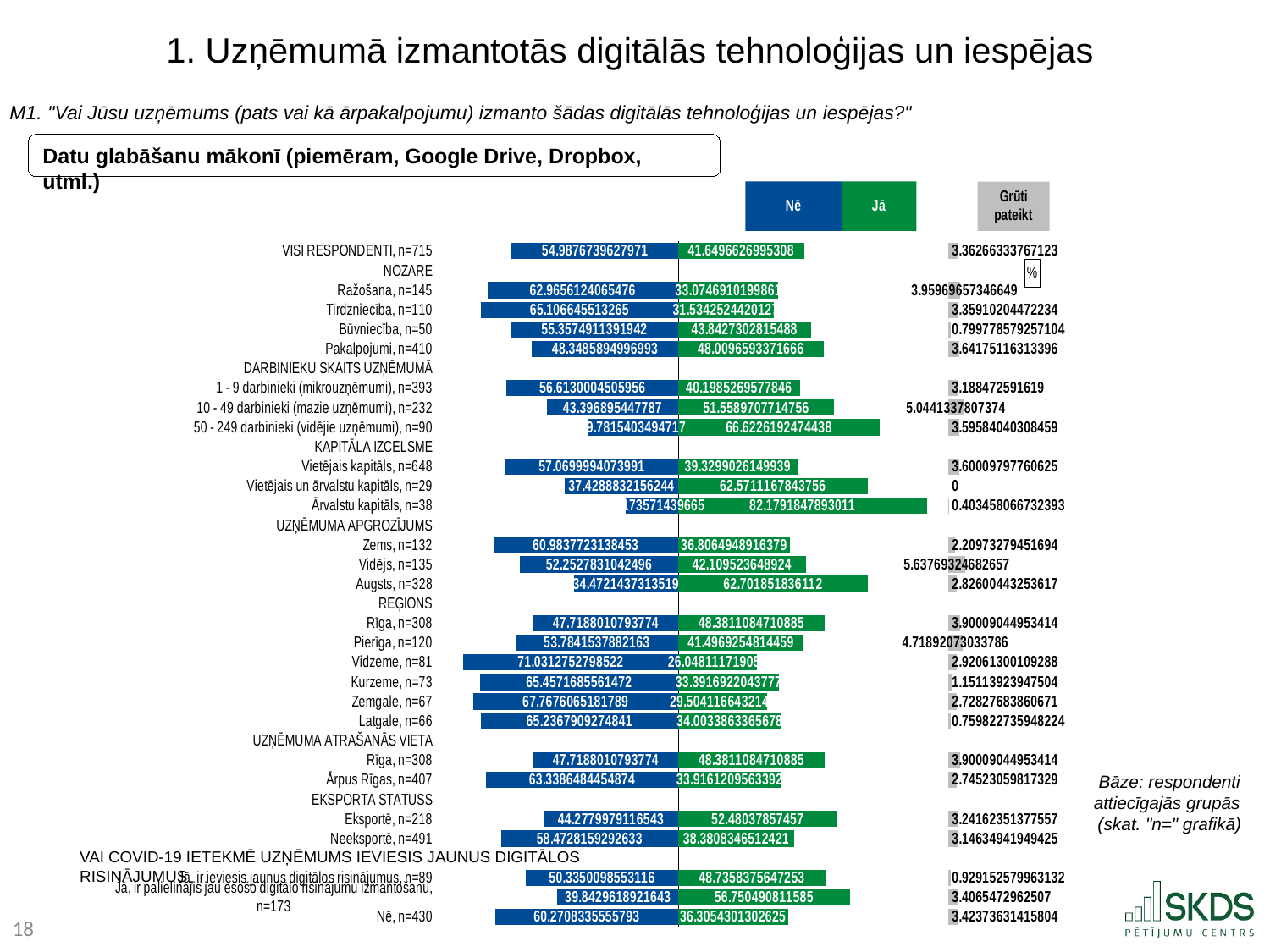
Which group has the lowest "Jā" value? Vidzeme, n=81 Which colour represents the "Jā" series in the legend? green What is the "Grūti pateikt" value for Vietējais un ārvalstu kapitāls, n=29? 0 What is the "Jā" value for Augsts, n=328? 62.701851836112 What is the "Nē" value for Vidzeme, n=81? 71.0312752798522 How many series does the legend list? 3 Which group has the highest "Jā" value? Ārvalstu kapitāls, n=38 Which is larger for Eksportē, n=218: the "Nē" value or the "Jā" value? Jā Is the "Nē" value for 50 - 249 darbinieki (vidējie uzņēmumi), n=90 greater or less than 40? less What is the "Jā" value for VISI RESPONDENTI, n=715? 41.6496626995308 What kind of chart is shown on the slide? bar chart What is the difference between the "Nē" and "Jā" values for Vidzeme, n=81? 44.9831635608022